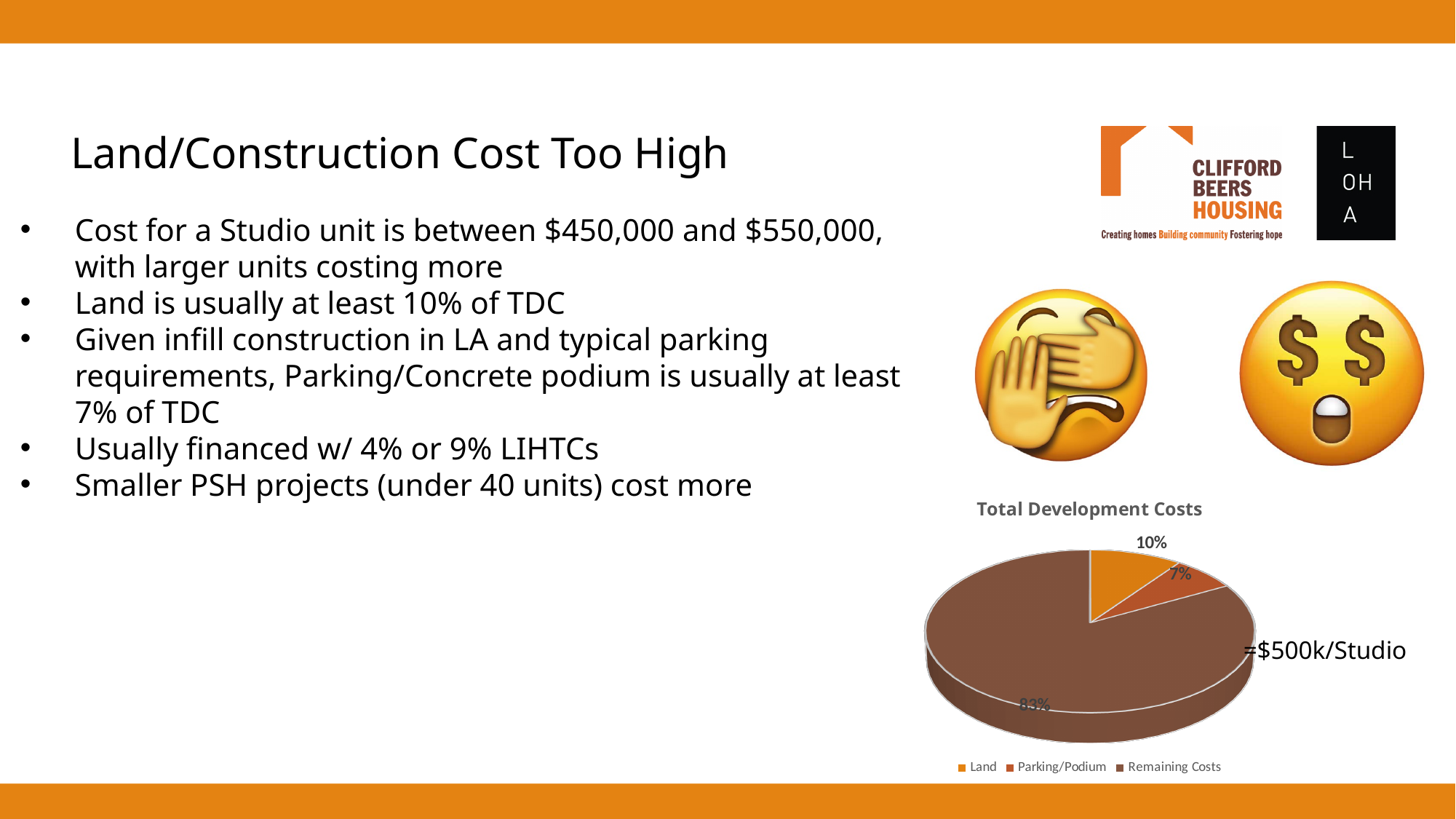
Which slice of the pie chart is the smallest? Parking/Podium What share of Total Development Costs is Land? 10% How many slices does the pie chart have? 3 What is the combined share of the Land and Parking/Podium slices? 17% What share of Total Development Costs is Parking/Podium? 7% What is the difference in percentage points between the Land and Parking/Podium slices? 3 percentage points What kind of chart is shown on the slide? pie chart How many entries does the chart legend list? 3 Which slice of the pie chart is the largest? Remaining Costs Which is larger in the pie chart, Land or Parking/Podium? Land What share of Total Development Costs is Remaining Costs? 83% What is the title of the pie chart? Total Development Costs